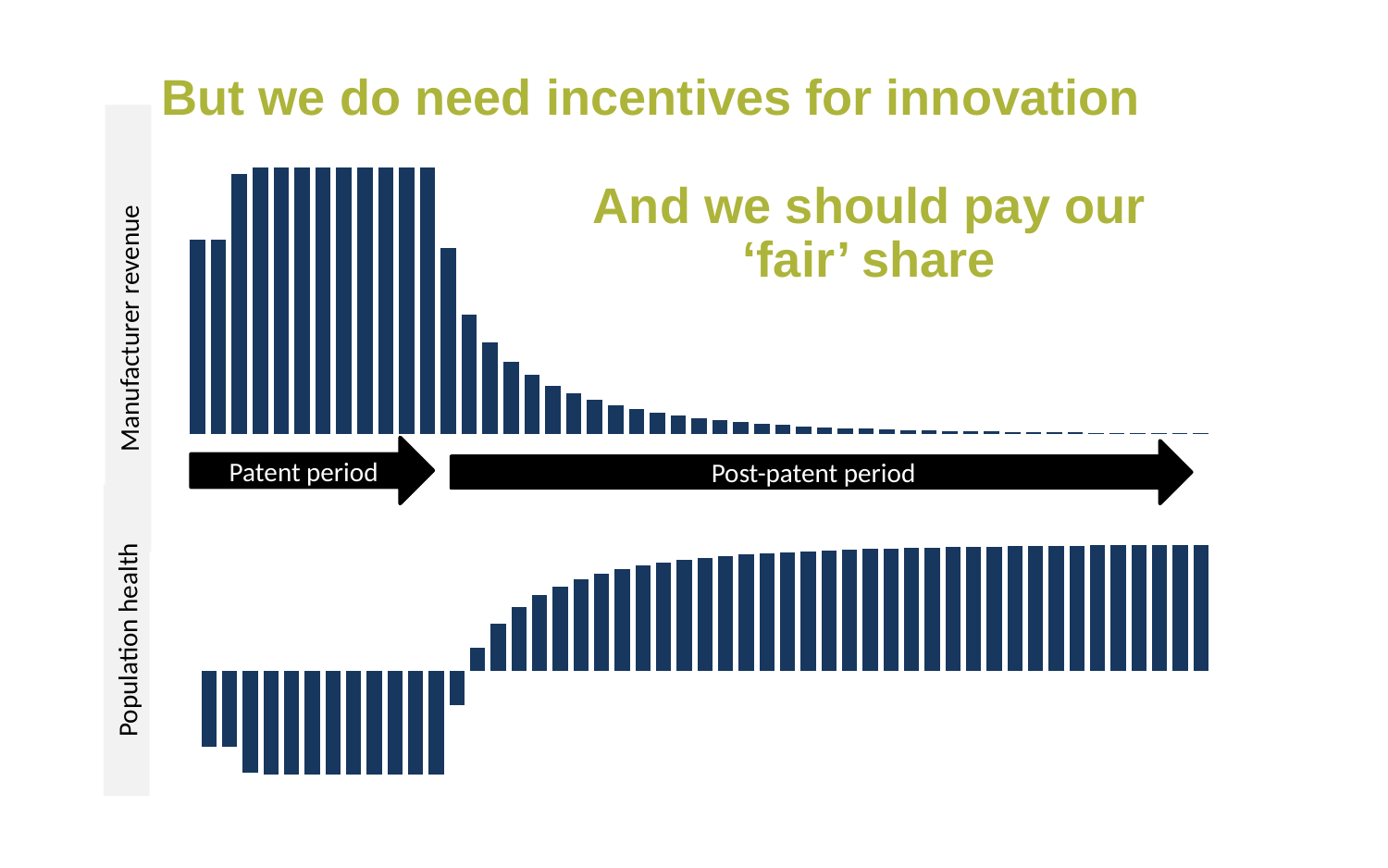
What kind of chart is the top chart labelled 'Manufacturer revenue'? Bar chart In the bottom chart (Population health), do the bars rise or fall across the post-patent period? Rise In the top chart (Manufacturer revenue), is revenue higher during the patent period or the post-patent period? Patent period What are the two periods labelled along the horizontal axis between the charts? Patent period and Post-patent period What does the vertical axis of the top chart represent? Manufacturer revenue In the top chart (Manufacturer revenue), do the bars at the very end of the post-patent period approach zero or stay high? Approach zero In the top chart (Manufacturer revenue), do the bars rise or fall across the post-patent period? Fall What kind of chart is the bottom chart labelled 'Population health'? Bar chart In the bottom chart (Population health), is population health higher during the patent period or the post-patent period? Post-patent period